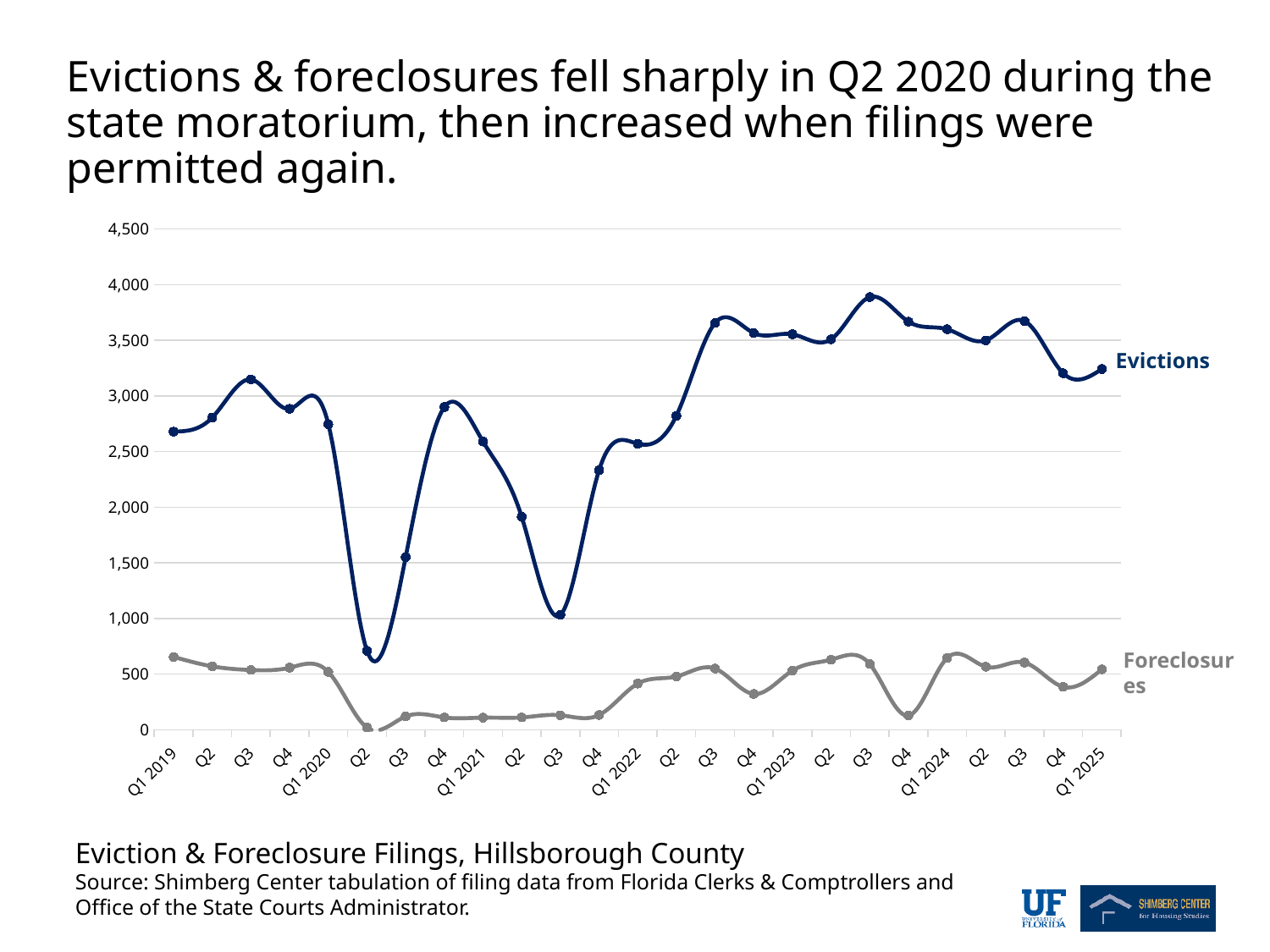
What is the title of the chart given below the plot? Eviction & Foreclosure Filings, Hillsborough County Is the Evictions value for Q3 2023 greater or less than 3,500? greater Is the Foreclosures value for Q4 2023 greater or less than 500? less How many series are plotted on the chart? 2 In which quarter is the Evictions line at its lowest? Q2 2020 What kind of chart is shown on the slide? Line chart In which quarter is the Evictions line at its highest? Q3 2023 How many quarterly data points does each line have, from Q1 2019 to Q1 2025? 25 Do Evictions rise or fall from Q4 2020 to Q3 2021? Fall In which quarter is the Foreclosures line at its lowest? Q2 2020 Is the Evictions value for Q2 2020 greater or less than 1,000? less Which is larger, the Evictions value for Q3 2019 or for Q1 2019? Q3 2019